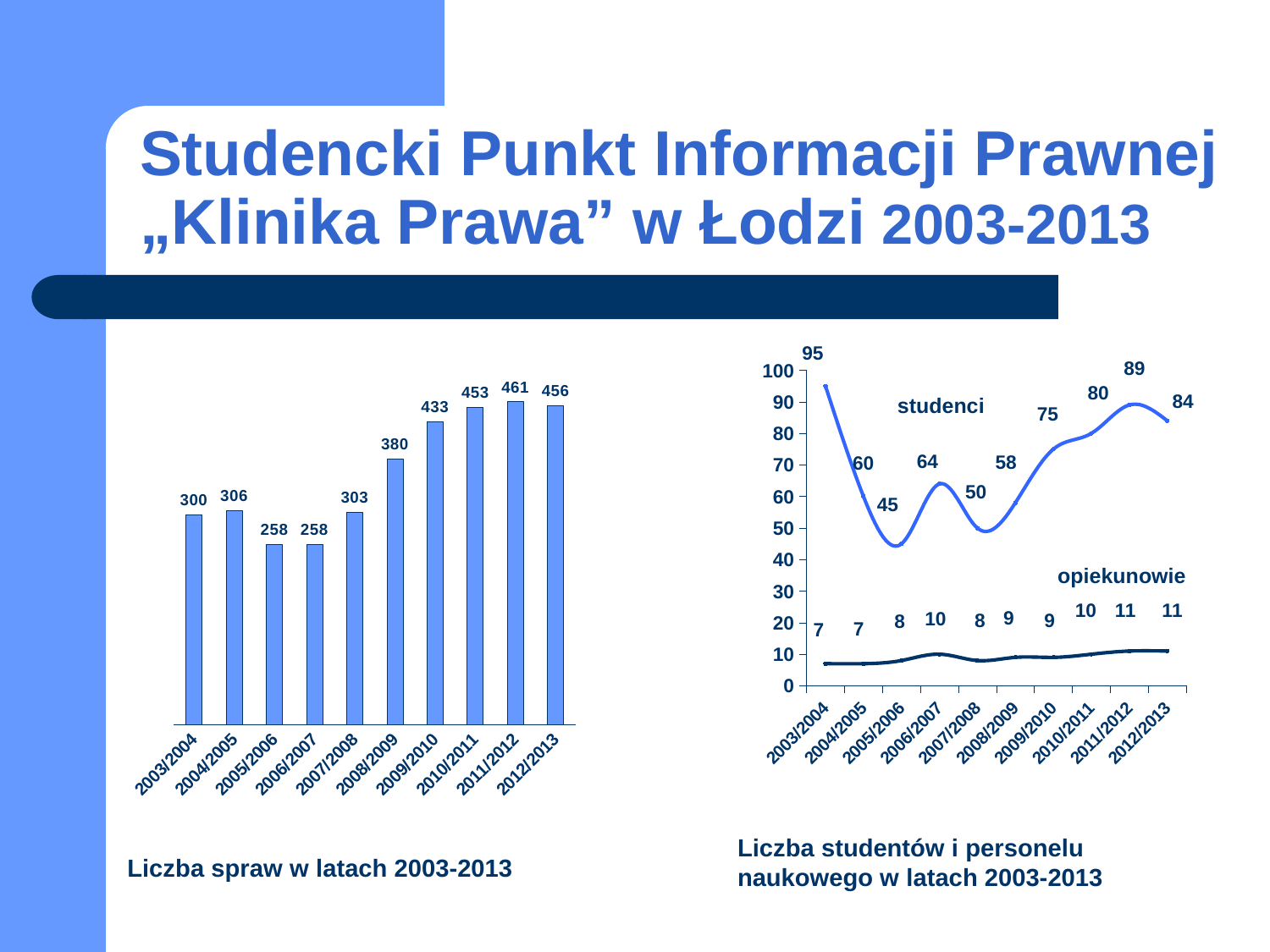
In the right chart (Liczba studentów i personelu naukowego), what is the difference between studenci and opiekunowie in 2012/2013? 73 In the left chart (Liczba spraw w latach 2003-2013), which is larger, the value for 2009/2010 or the value for 2010/2011? 2010/2011 In the left chart (Liczba spraw w latach 2003-2013), how many years are shown on the x axis? 10 In the left chart (Liczba spraw w latach 2003-2013), what is the difference between the values for 2012/2013 and 2003/2004? 156 What kind of chart is the left chart (Liczba spraw w latach 2003-2013)? bar chart In the left chart (Liczba spraw w latach 2003-2013), what is the value for 2008/2009? 380 In the right chart (Liczba studentów i personelu naukowego), what is the value for opiekunowie in 2006/2007? 10 In the right chart (Liczba studentów i personelu naukowego), what is the value for studenci in 2005/2006? 45 In the left chart (Liczba spraw w latach 2003-2013), which year has the highest value? 2011/2012 In the right chart (Liczba studentów i personelu naukowego), in which year is the studenci value highest? 2003/2004 In the right chart (Liczba studentów i personelu naukowego), how many series are plotted? 2 What kind of chart is the right chart (Liczba studentów i personelu naukowego)? line chart